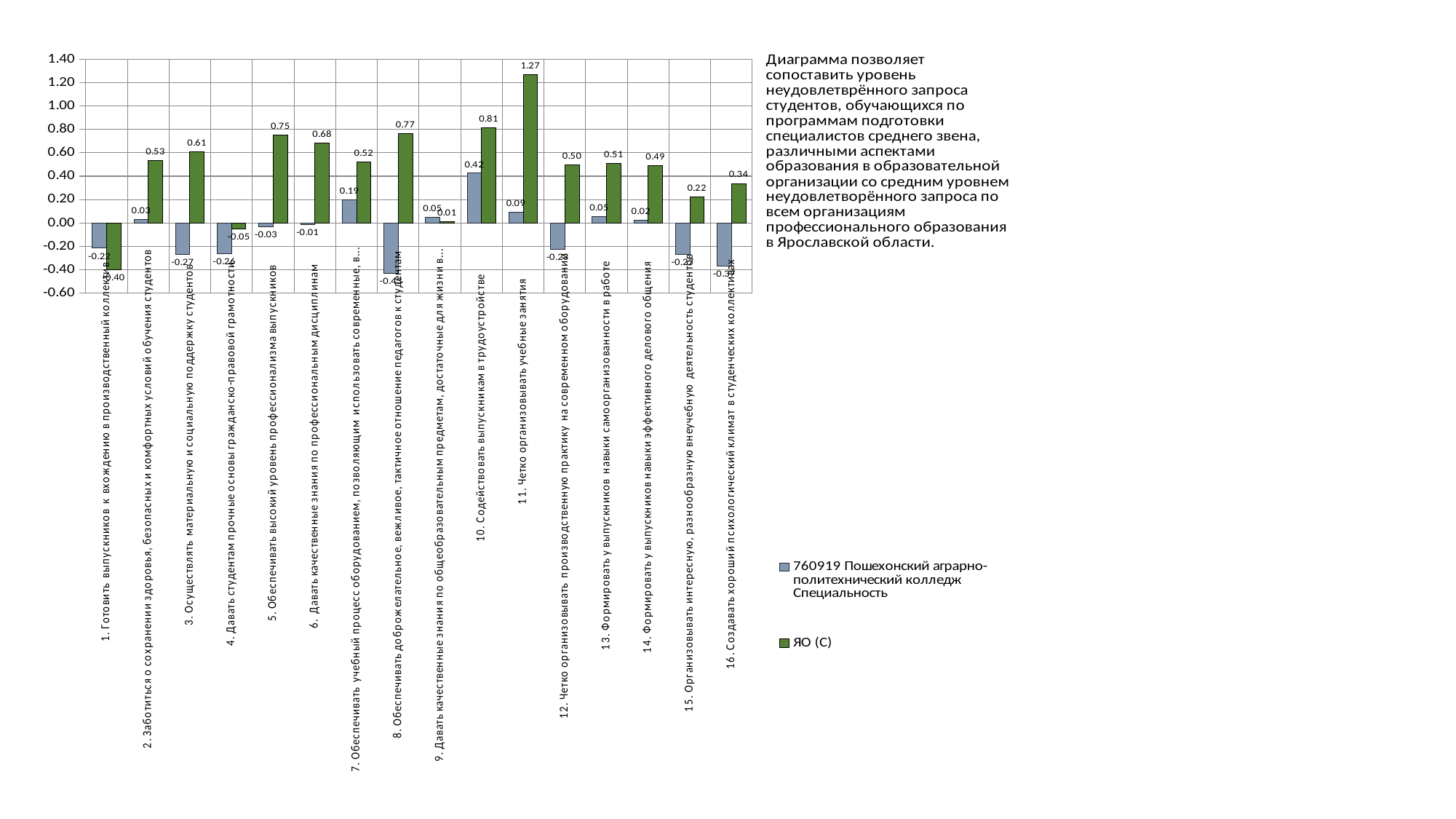
What is the value of the ЯО (С) series for category 5 (Обеспечивать высокий уровень профессионализма выпускников)? 0.75 What colour are the bars for the ЯО (С) series? green What is the difference between the ЯО (С) value and the 760919 Пошехонский колледж value for category 11? 1.18 For category 2, which series has the larger value: ЯО (С) or 760919 Пошехонский колледж? ЯО (С) How many categories are plotted along the x axis? 16 What is the value of the 760919 Пошехонский аграрно-политехнический колледж series for category 10 (Содействовать выпускникам в трудоустройстве)? 0.42 Which category has the highest value in the ЯО (С) series? 11. Четко организовывать учебные занятия How many series does the legend list? 2 Is the ЯО (С) value for category 10 greater or less than 0.60? greater What kind of chart is shown on the slide? bar chart What is the value of the ЯО (С) series for category 11 (Четко организовывать учебные занятия)? 1.27 Which category has the lowest value in the ЯО (С) series? 1. Готовить выпускников к вхождению в производственный коллектив